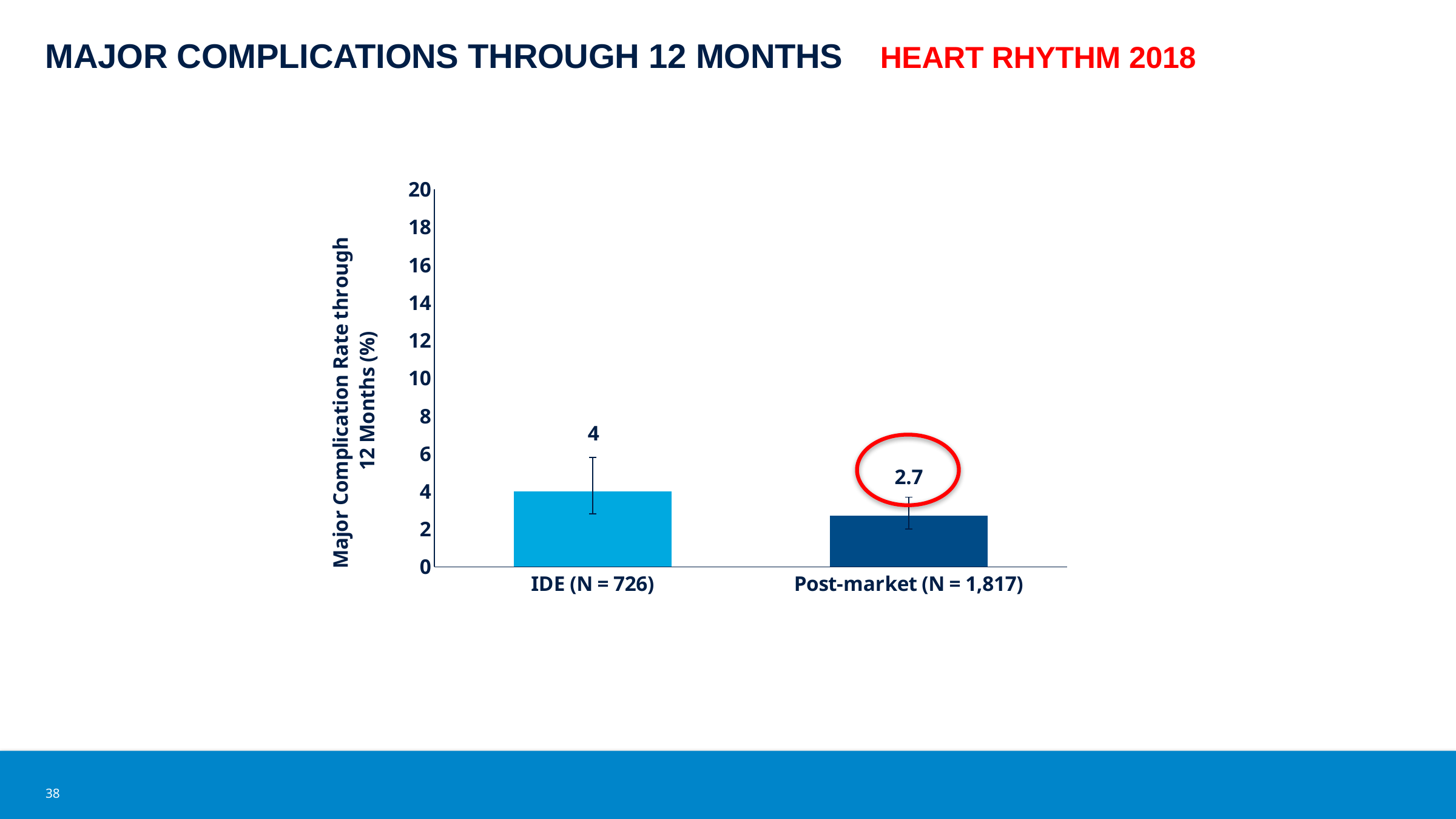
Which category has the highest major complication rate? IDE (N = 726) What is the major complication rate for Post-market (N = 1,817)? 2.7 Do the values rise or fall from IDE to Post-market along the x axis? fall Which category has the lowest major complication rate? Post-market (N = 1,817) Is the value for Post-market (N = 1,817) greater or less than 4? less What is the major complication rate for IDE (N = 726)? 4 Which is larger, the major complication rate for IDE or for Post-market? IDE What is the label of the y axis? Major Complication Rate through 12 Months (%) What is the maximum value shown on the y axis? 20 How many categories are shown on the x axis? 2 What is the difference between the IDE and Post-market major complication rates? 1.3 What kind of chart is shown on the slide? bar chart